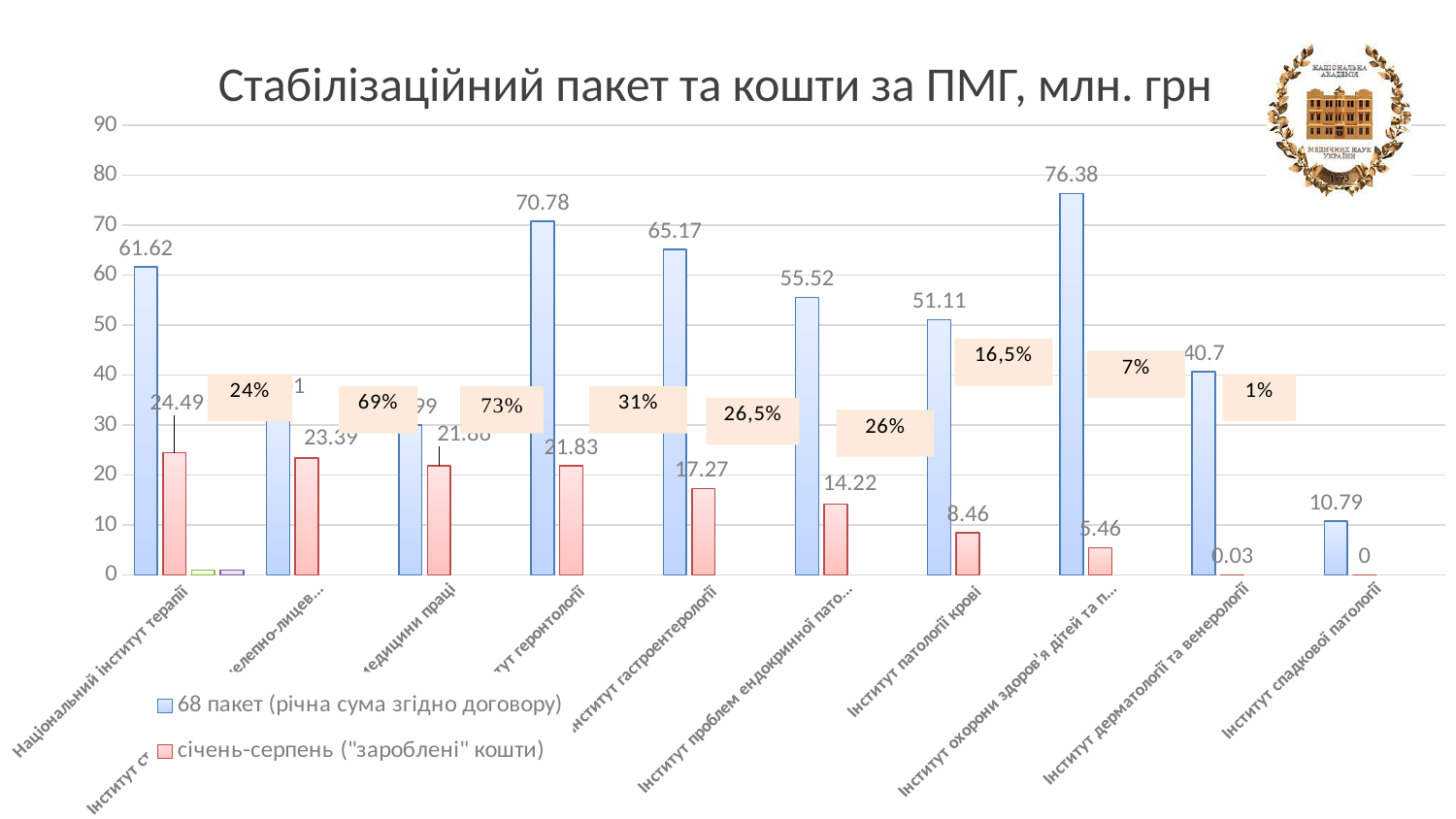
How many series does the legend list? 2 Which institute has the lowest value in the '68 пакет (річна сума згідно договору)' series? Інститут спадкової патології Which institute has the highest value in the '68 пакет (річна сума згідно договору)' series? Інститут охорони здоров'я дітей та п... Which institute has the highest value in the 'січень-серпень ("зароблені" кошти)' series? Національний інститут терапії What is the value of the '68 пакет (річна сума згідно договору)' series for Інститут геронтології? 70.78 Which is larger: the '68 пакет' value for Інститут геронтології or for Інститут гастроентерології? Інститут геронтології How many institutes (categories) are shown on the x axis? 10 What is the difference between the '68 пакет' value and the 'січень-серпень' value for Інститут гастроентерології? 47.9 What kind of chart is shown on the slide? bar chart What percentage label is shown above Інститут дерматології та венерології? 1% What is the value of the 'січень-серпень ("зароблені" кошти)' series for Інститут патології крові? 8.46 What is the title of the chart? Стабілізаційний пакет та кошти за ПМГ, млн. грн